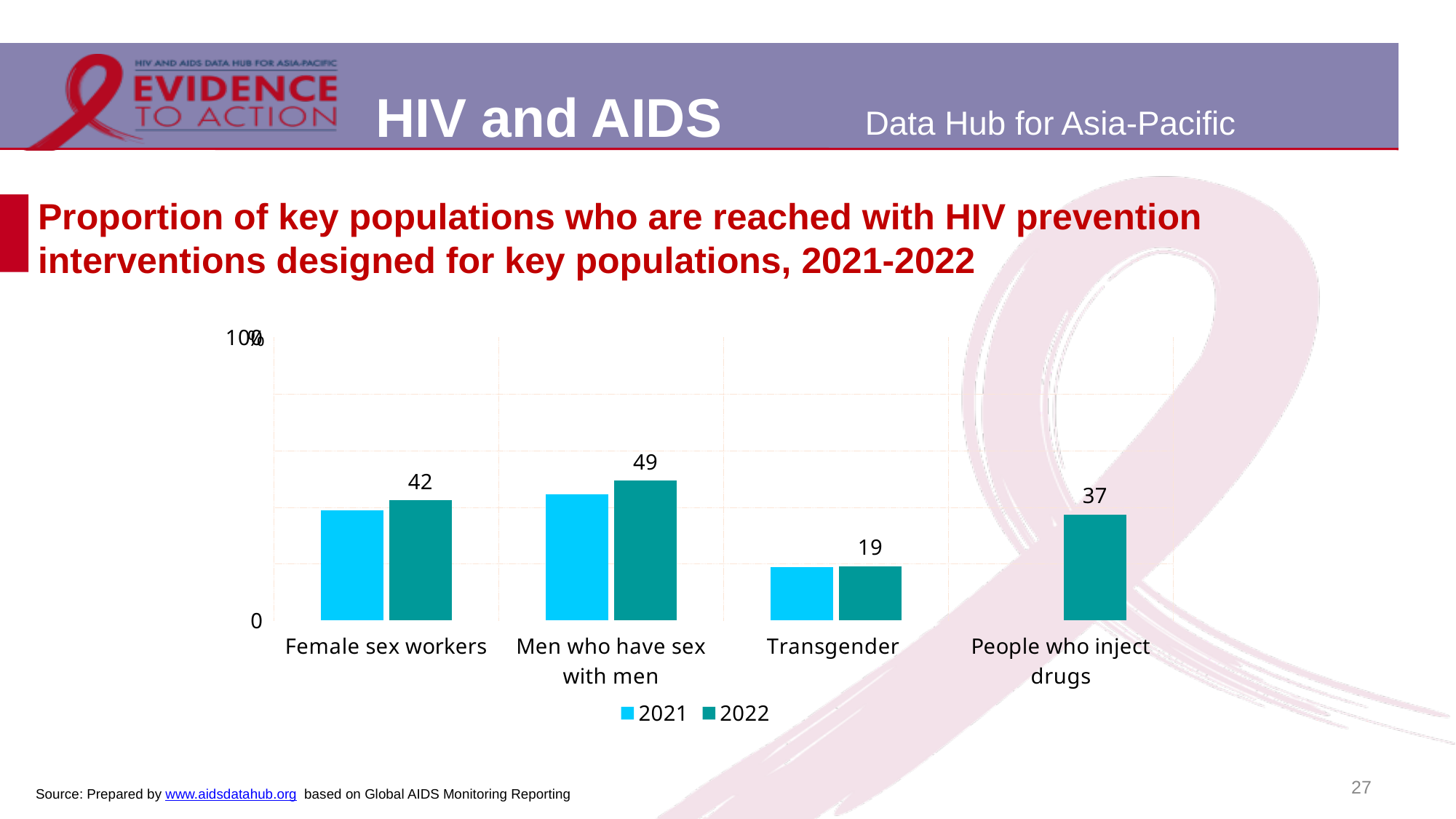
What is the 2022 value for Female sex workers? 42 Which key population has the highest 2022 value? Men who have sex with men What is the difference between the 2022 values for People who inject drugs and Transgender? 18 What is the 2022 value for People who inject drugs? 37 How many series does the legend list? 2 How many key population categories are shown on the x axis? 4 What is the 2022 value for Men who have sex with men? 49 Which is larger, the 2022 value for Female sex workers or the 2022 value for People who inject drugs? Female sex workers What kind of chart is shown on the slide? Bar chart What is the 2022 value for Transgender? 19 Which key population has the lowest 2022 value? Transgender What is the difference between the 2022 values for Men who have sex with men and Female sex workers? 7